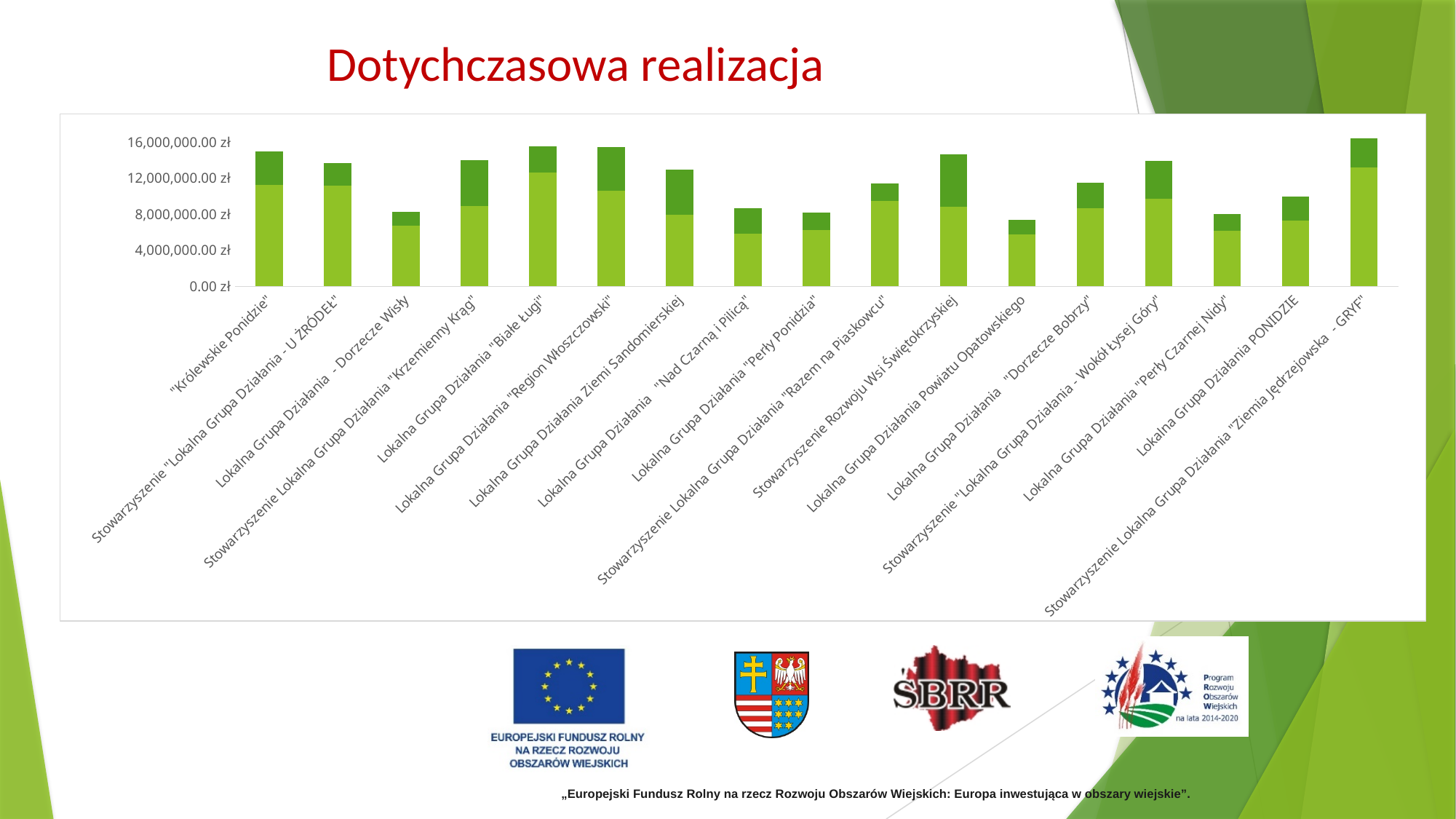
Is the total value for Lokalna Grupa Działania Powiatu Opatowskiego greater or less than 8,000,000.00 zł? less Which organisation has the lowest total bar on the chart? Lokalna Grupa Działania Powiatu Opatowskiego Is the total value for Stowarzyszenie Lokalna Grupa Działania "Razem na Piaskowcu" greater or less than 12,000,000.00 zł? less What kind of chart is shown on the slide? Stacked bar chart Is the total value for "Królewskie Ponidzie" greater or less than 12,000,000.00 zł? greater Which has the larger total bar: Stowarzyszenie Lokalna Grupa Działania "Krzemienny Krąg" or Lokalna Grupa Działania - Dorzecze Wisły? Stowarzyszenie Lokalna Grupa Działania "Krzemienny Krąg" What is the title of the slide containing the chart? Dotychczasowa realizacja How many organisations (categories) are plotted on the chart? 17 What is the highest value labelled on the vertical axis of the chart? 16,000,000.00 zł Which organisation has the highest total bar on the chart? Stowarzyszenie Lokalna Grupa Działania "Ziemia Jędrzejowska - GRYF" Which has the larger total bar: Stowarzyszenie "Lokalna Grupa Działania - Wokół Łysej Góry" or Lokalna Grupa Działania "Perły Czarnej Nidy"? Stowarzyszenie "Lokalna Grupa Działania - Wokół Łysej Góry"